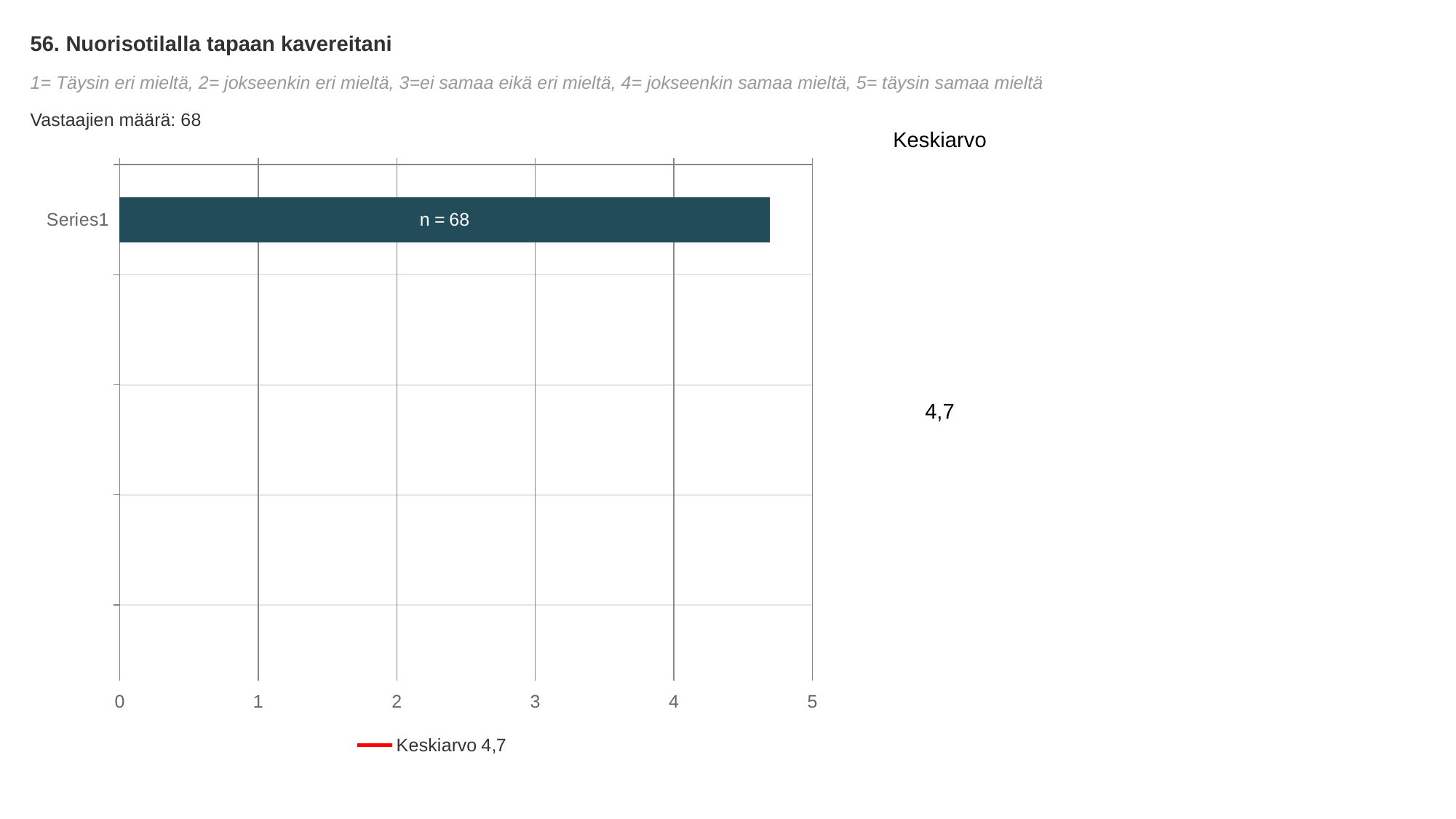
What is the Keskiarvo (mean) value shown on the slide? 4,7 Is the value of the Series1 bar greater or less than 5? less What does the legend entry below the chart say? Keskiarvo 4,7 What is the label of the only category on the vertical axis? Series1 What kind of chart is shown on the slide? bar chart How many respondents (Vastaajien määrä) are reported on the slide? 68 Is the value of the Series1 bar greater or less than 4? greater What data label is printed on the Series1 bar? n = 68 What is the highest value shown on the horizontal axis? 5 How many bars are plotted in the chart? 1